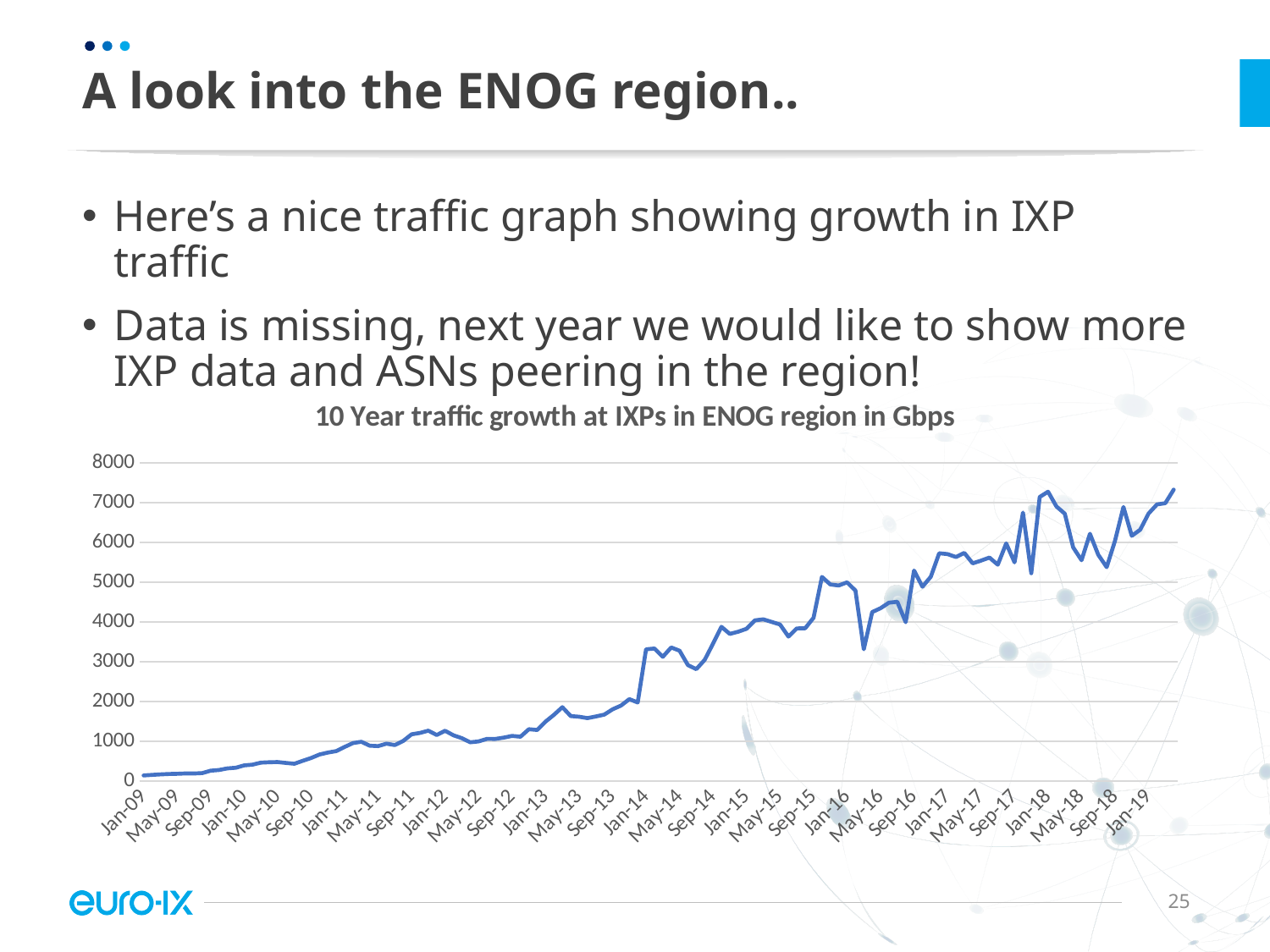
Which is larger, the value for Jan-19 or the value for Jan-09? Jan-19 Which is larger, the value for Jan-17 or the value for Jan-13? Jan-17 Is the value for Jan-17 greater or less than 5000? greater Is the value for Jan-09 greater or less than 1000? less Overall, does the traffic value rise or fall from Jan-09 to Jan-19? rise What is the title of the chart? 10 Year traffic growth at IXPs in ENOG region in Gbps Is the value for Jan-15 greater or less than 3000? greater What kind of chart is shown on the slide? line chart What is the highest value shown on the vertical axis? 8000 How many date labels are shown along the x axis? 31